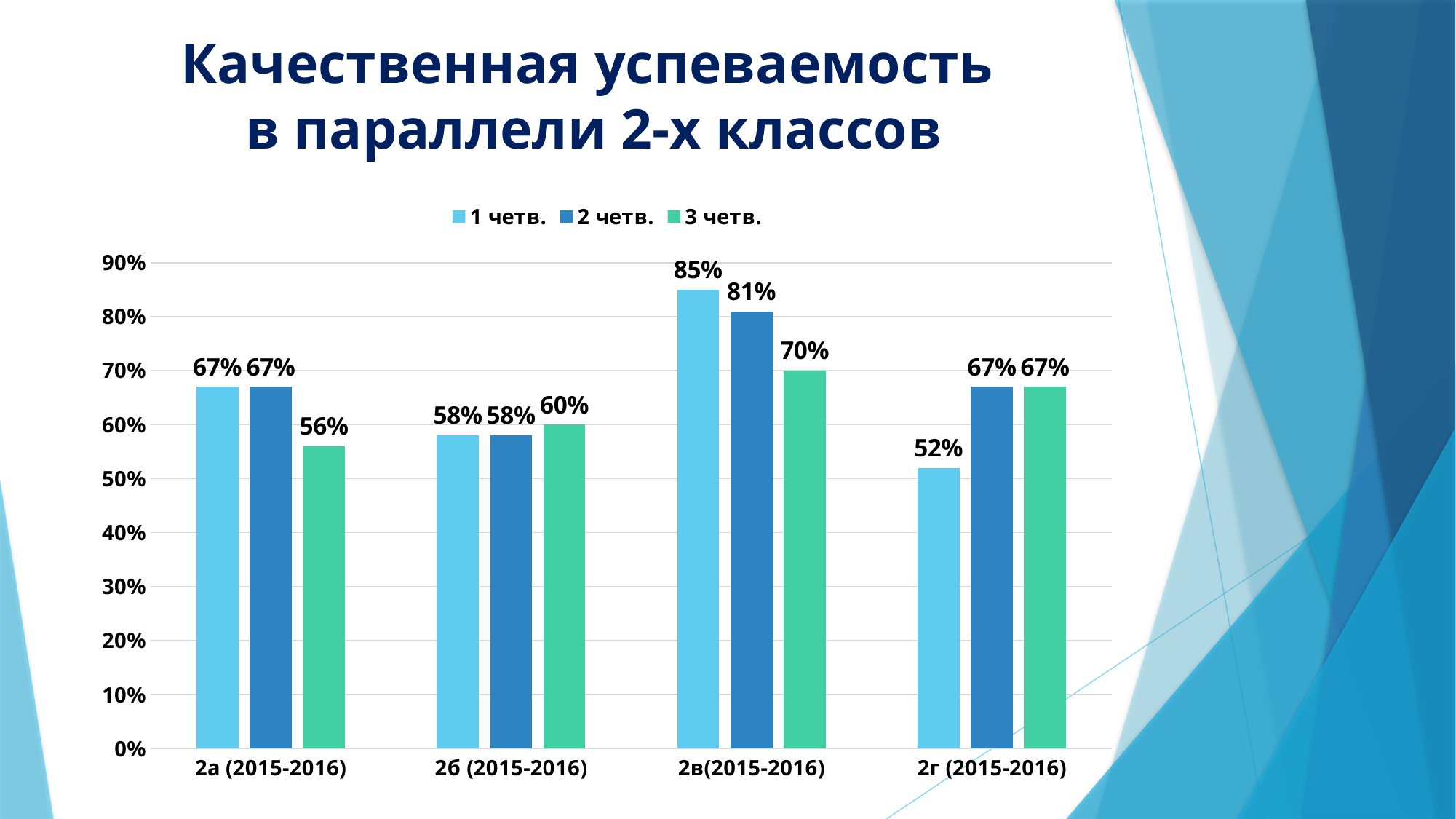
What kind of chart is shown on the slide? Bar chart What is the title of the slide? Качественная успеваемость в параллели 2-х классов Which class has the highest value in the 2 четв. series? 2в(2015-2016) Which is larger for 2г (2015-2016): the 1 четв. value or the 2 четв. value? 2 четв. What is the difference between the 1 четв. and 3 четв. values for 2в(2015-2016)? 15% What is the value for 2а (2015-2016) in the 3 четв. series? 56% What is the value for 2б (2015-2016) in the 2 четв. series? 58% What is the value for 2г (2015-2016) in the 1 четв. series? 52% How many classes are shown on the x axis? 4 Which class has the lowest value in the 1 четв. series? 2г (2015-2016) What is the value for 2в(2015-2016) in the 1 четв. series? 85% How many series does the legend list? 3